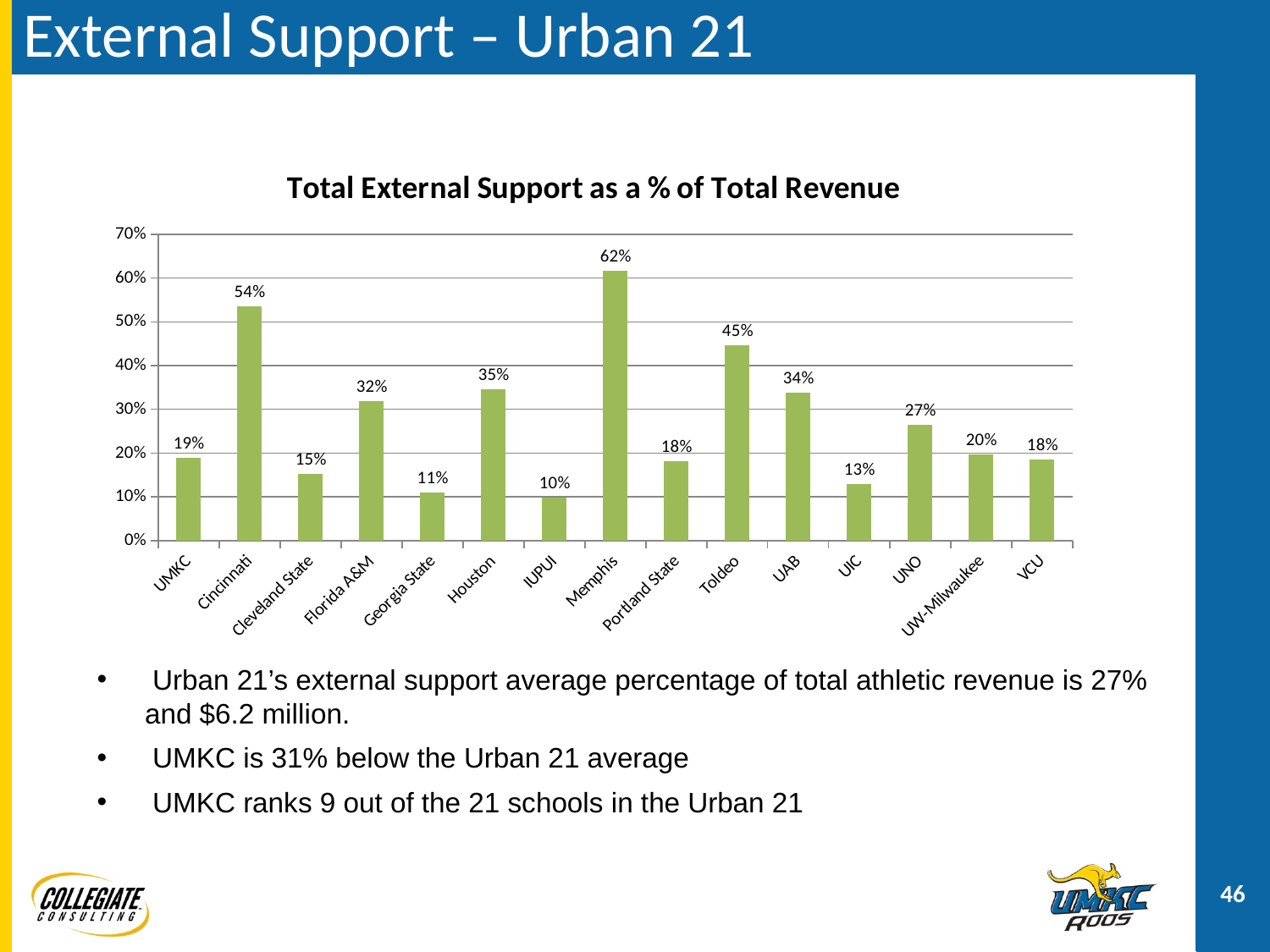
Is the value for Cincinnati greater or less than 50%? greater How many schools are shown in the chart? 15 What type of chart is shown on the slide? Bar chart What is the value for UMKC in the chart? 19% What is the difference between the values for Memphis and Cincinnati? 8% Which school has the lowest total external support as a % of total revenue? IUPUI What is the title of the chart? Total External Support as a % of Total Revenue What is the difference between the values for UMKC and Georgia State? 8% What is the value for UW-Milwaukee in the chart? 20% What is the value for Toldeo in the chart? 45% Which school has the highest total external support as a % of total revenue? Memphis Which is larger, the value for Florida A&M or the value for Toldeo? Toldeo